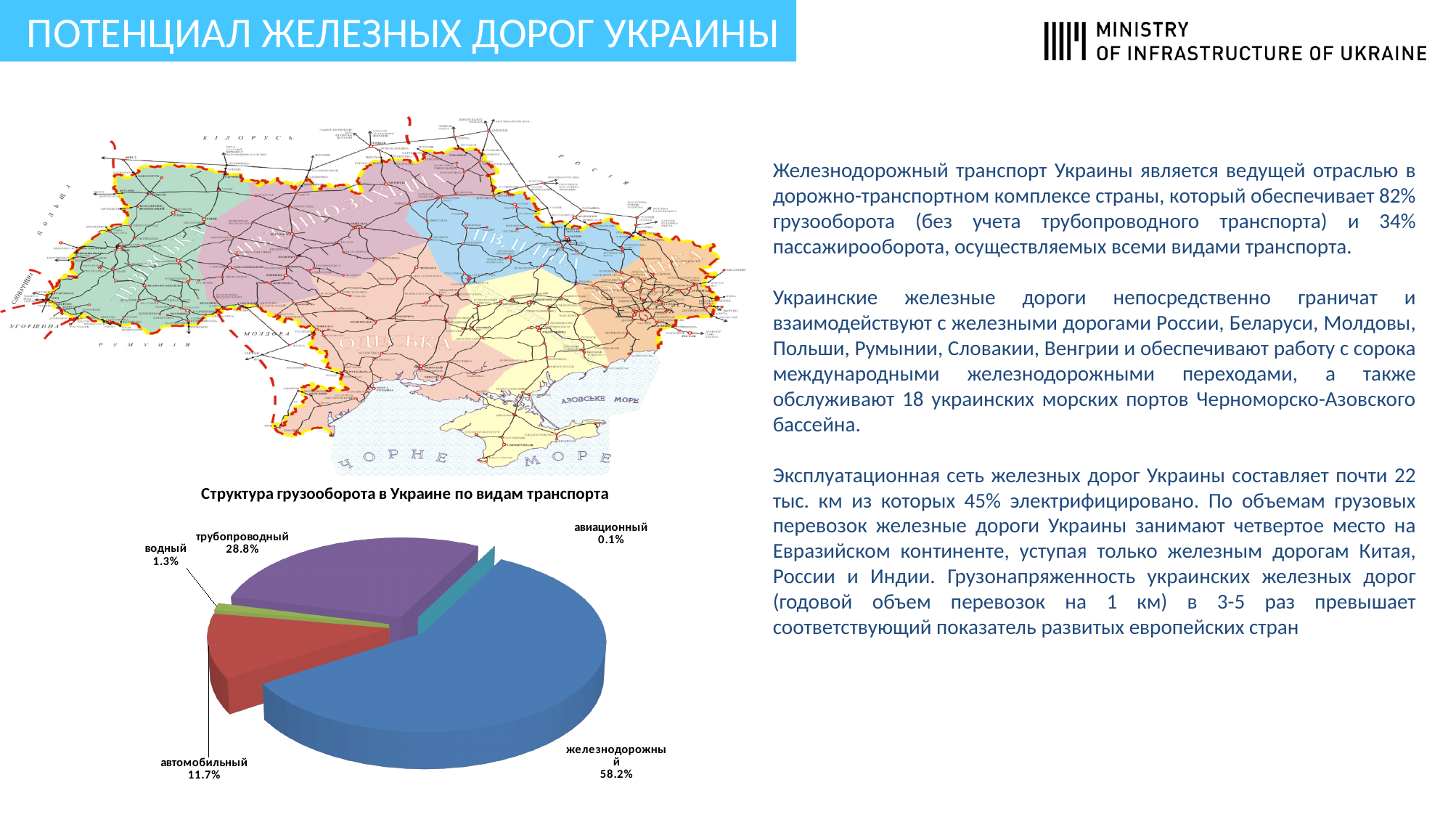
How many slices does the pie chart have? 5 What is the title of the chart on the slide? Структура грузооборота в Украине по видам транспорта Which type of transport has the smallest slice in the pie chart? авиационный What type of chart is shown on the slide? pie chart Which slice is larger in the pie chart: автомобильный or водный? автомобильный What share does автомобильный transport have in the pie chart? 11.7% What is the difference in percentage points between the железнодорожный and трубопроводный slices? 29.4 What share does водный transport have in the pie chart? 1.3% What share does авиационный transport have in the pie chart? 0.1% What share of freight turnover does железнодорожный transport have in the pie chart? 58.2% Which type of transport has the largest slice in the pie chart? железнодорожный What share does трубопроводный transport have in the pie chart? 28.8%